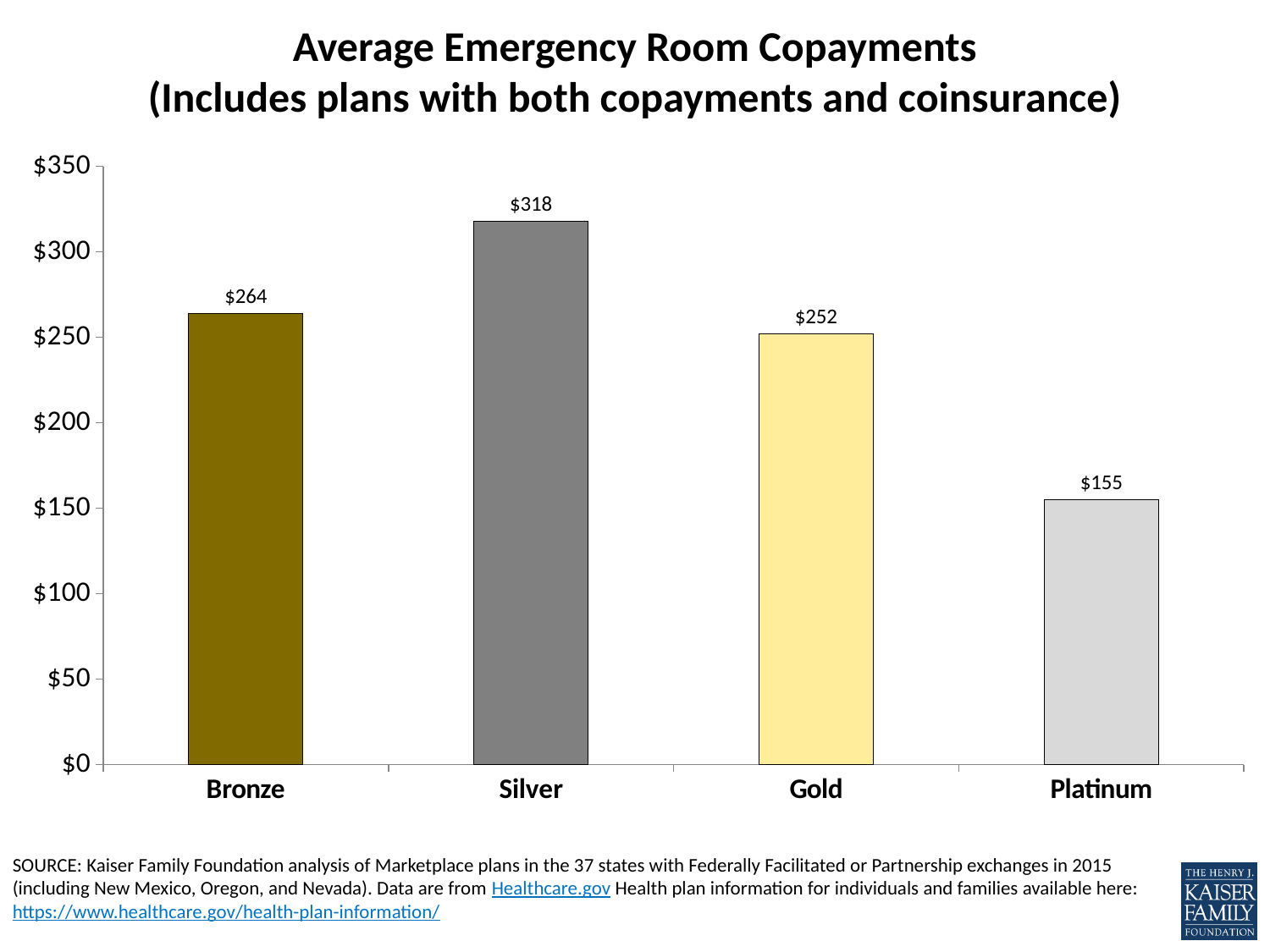
What is the average emergency room copayment for Silver plans? $318 What is the average emergency room copayment for Bronze plans? $264 How many plan types are shown on the chart? 4 What is the title of the chart? Average Emergency Room Copayments (Includes plans with both copayments and coinsurance) Which plan type has the lowest average emergency room copayment? Platinum What is the difference between the Silver and Platinum average emergency room copayments? $163 What is the average emergency room copayment for Platinum plans? $155 What kind of chart is shown on the slide? Bar chart Which plan type has the highest average emergency room copayment? Silver Which has a higher average emergency room copayment, Bronze or Gold? Bronze What is the difference between the Bronze and Gold average emergency room copayments? $12 Is the value for Gold greater or less than $300? less